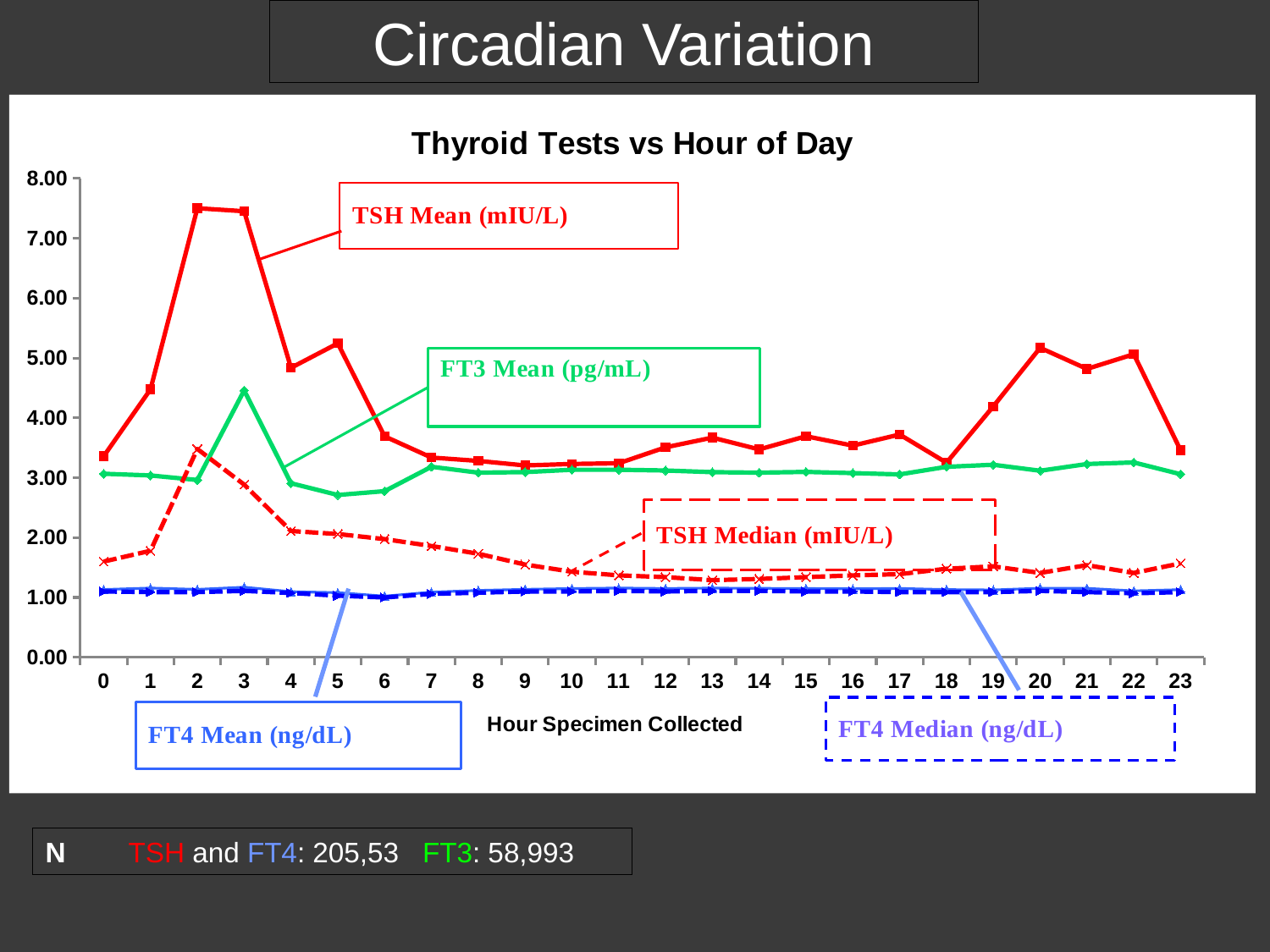
At hour 2, which is larger: TSH Mean or FT3 Mean? TSH Mean Is the TSH Mean value at hour 12 greater or less than 4.00? less Which is larger for TSH Mean: the value at hour 2 or the value at hour 20? hour 2 At which hour does the FT3 Mean series reach its highest value? 3 What kind of chart is shown on the slide? line chart Does the TSH Mean series rise or fall from hour 3 to hour 6? fall What is the title of the x axis of the chart? Hour Specimen Collected How many series are labelled on the chart? 5 Is the TSH Mean value at hour 2 greater or less than 7.00? greater Is the FT4 Mean value at hour 10 greater or less than 2.00? less How many hours are plotted along the x axis of the chart? 24